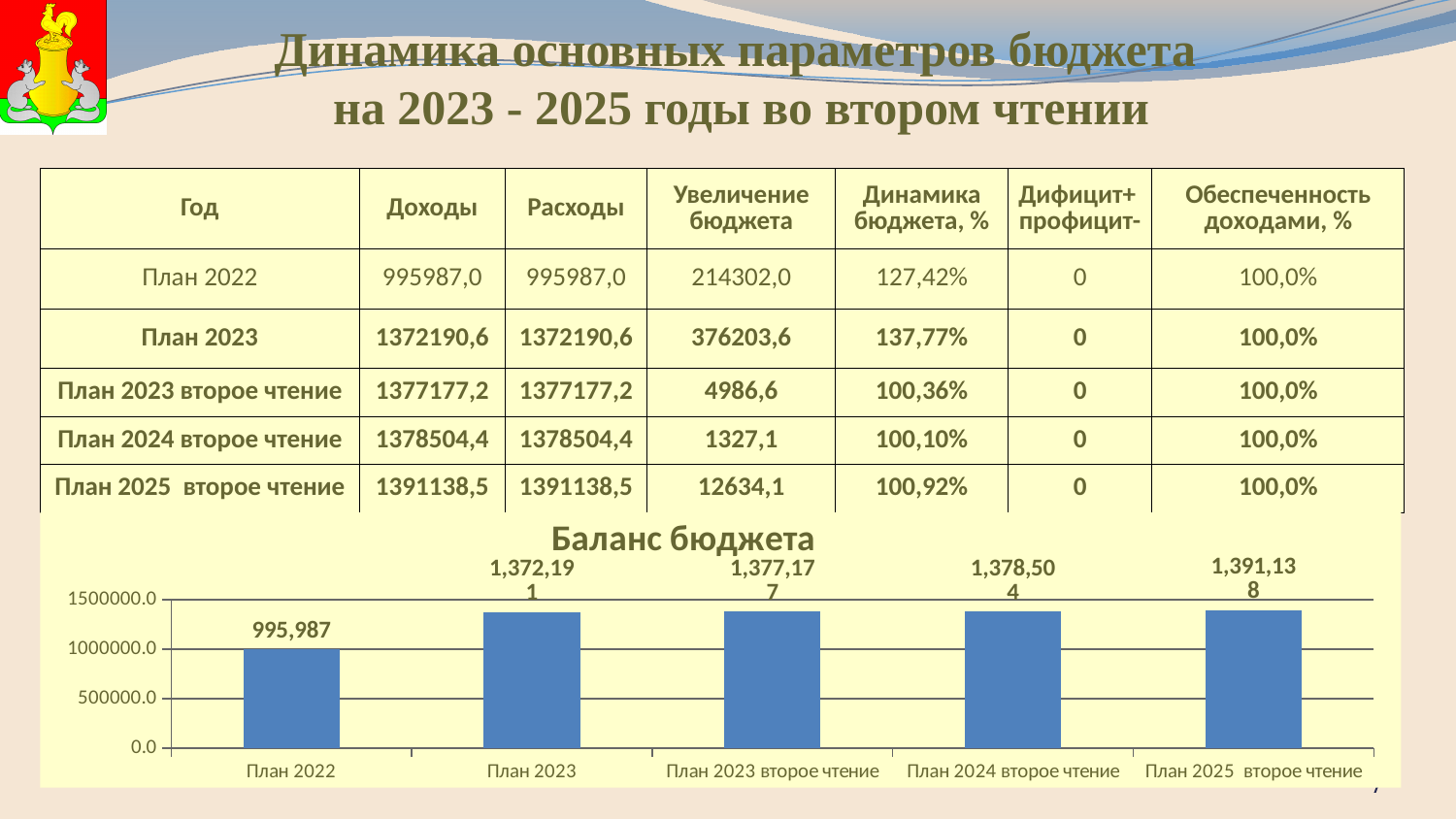
In the chart 'Баланс бюджета', what is the value for План 2022? 995,987 In the chart 'Баланс бюджета', is the value for План 2024 второе чтение greater or less than 1000000.0? greater In the chart 'Баланс бюджета', do the values rise or fall from left to right along the x axis? rise In the chart 'Баланс бюджета', what is the value for План 2025 второе чтение? 1,391,138 In the chart 'Баланс бюджета', which category has the highest value? План 2025 второе чтение How many bars are shown in the chart 'Баланс бюджета'? 5 In the chart 'Баланс бюджета', what is the difference between the values for План 2023 второе чтение and План 2023? 4,986 In the chart 'Баланс бюджета', which is larger: the value for План 2022 or the value for План 2023? План 2023 In the chart 'Баланс бюджета', what is the difference between the values for План 2025 второе чтение and План 2022? 395,151 In the chart 'Баланс бюджета', which category has the lowest value? План 2022 In the chart 'Баланс бюджета', what is the value for План 2023 второе чтение? 1,377,177 What type of chart is 'Баланс бюджета'? bar chart